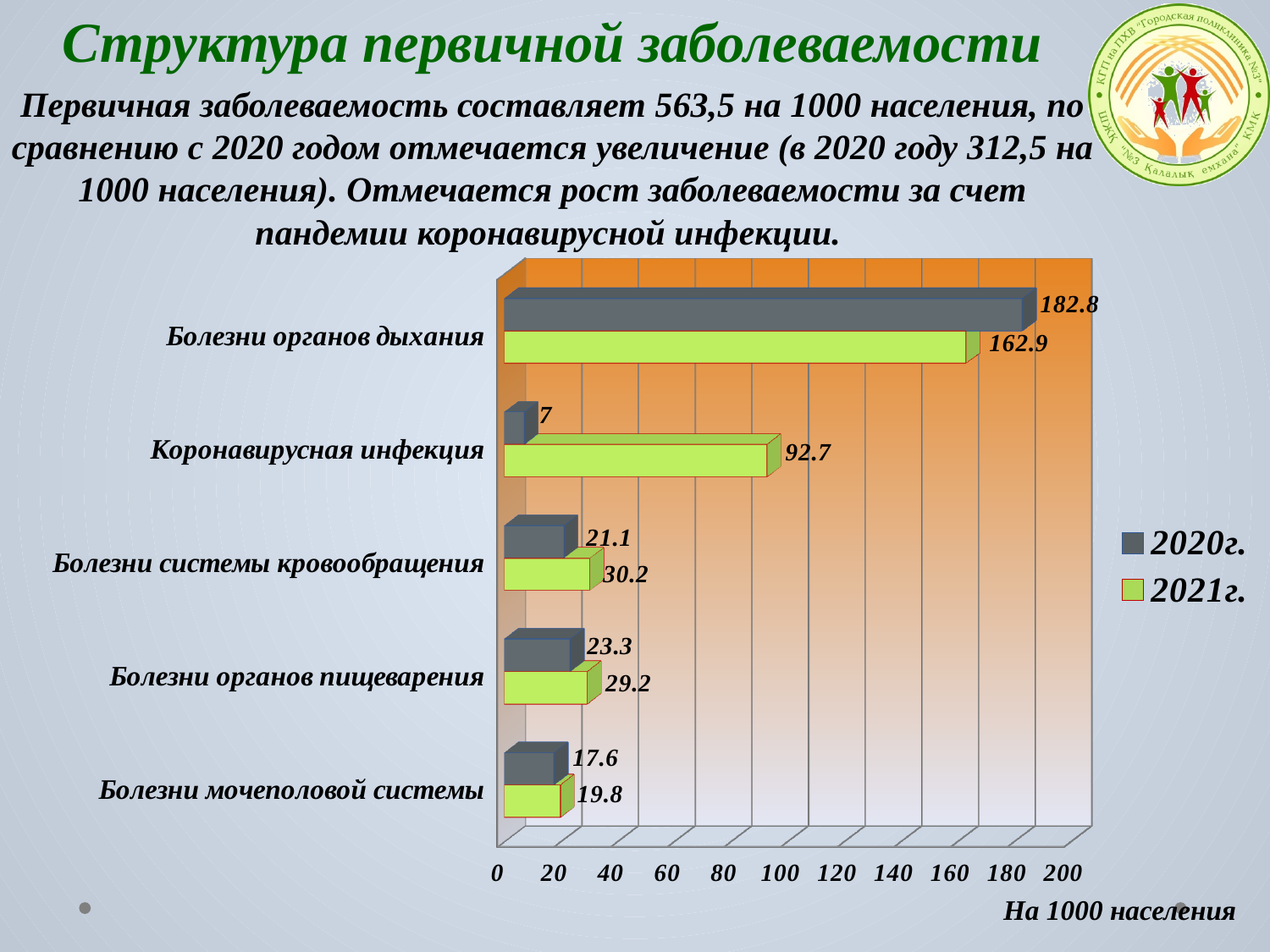
How many series does the legend list? 2 Is the 2021г. value for Коронавирусная инфекция greater or less than 80? greater What is the 2020г. value for Коронавирусная инфекция? 7 Which category has the lowest 2020г. value? Коронавирусная инфекция What kind of chart is shown on the slide? Bar chart What is the 2020г. value for Болезни органов дыхания? 182.8 What is the 2021г. value for Коронавирусная инфекция? 92.7 What is the difference between the 2020г. and 2021г. values for Болезни органов дыхания? 19.9 What is the 2021г. value for Болезни мочеполовой системы? 19.8 Which is larger for Болезни системы кровообращения: the 2020г. value or the 2021г. value? 2021г. How many categories are shown on the chart? 5 Which category has the highest 2021г. value? Болезни органов дыхания